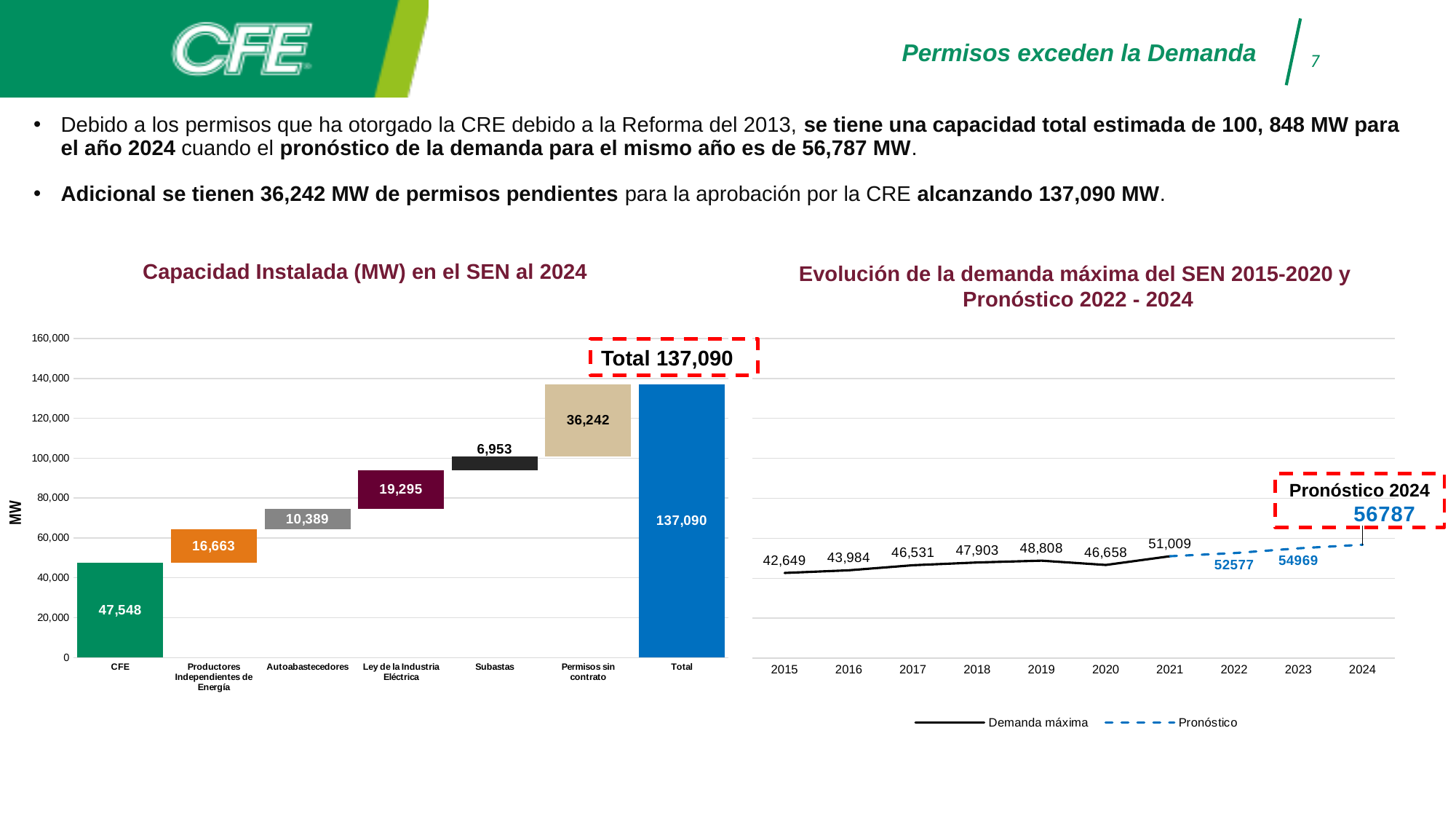
In the chart 'Evolución de la demanda máxima del SEN 2015-2020 y Pronóstico 2022 - 2024', do the values generally rise or fall from 2015 to 2024? Rise In the chart 'Evolución de la demanda máxima del SEN 2015-2020 y Pronóstico 2022 - 2024', how many series does the legend list? 2 What kind of chart is 'Capacidad Instalada (MW) en el SEN al 2024'? Bar chart In the chart 'Capacidad Instalada (MW) en el SEN al 2024', which is larger: Productores Independientes de Energía or Autoabastecedores? Productores Independientes de Energía In the chart 'Capacidad Instalada (MW) en el SEN al 2024', how many categories are shown on the x axis? 7 In the chart 'Evolución de la demanda máxima del SEN 2015-2020 y Pronóstico 2022 - 2024', what is the difference between the values for 2021 and 2020? 4,351 In the chart 'Evolución de la demanda máxima del SEN 2015-2020 y Pronóstico 2022 - 2024', what is the forecast value for 2024? 56787 In the chart 'Capacidad Instalada (MW) en el SEN al 2024', what is the value for Permisos sin contrato? 36,242 In the chart 'Capacidad Instalada (MW) en el SEN al 2024', what is the difference between the values for Ley de la Industria Eléctrica and Autoabastecedores? 8,906 In the chart 'Evolución de la demanda máxima del SEN 2015-2020 y Pronóstico 2022 - 2024', what is the value for 2019? 48,808 In the chart 'Capacidad Instalada (MW) en el SEN al 2024', what is the value for CFE? 47,548 In the chart 'Capacidad Instalada (MW) en el SEN al 2024', which category other than Total has the lowest value? Subastas